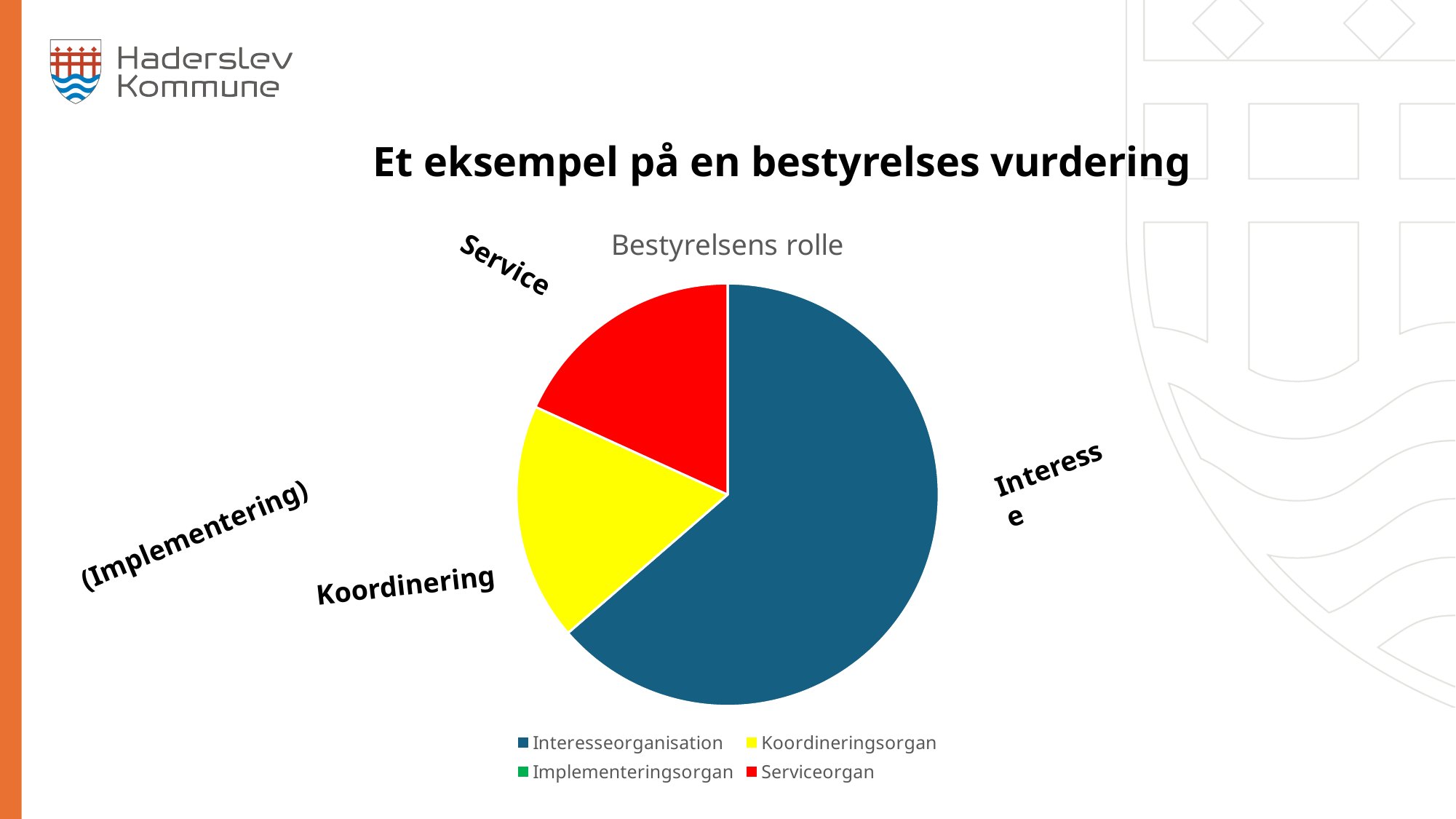
Does the Interesseorganisation slice take up more or less than half of the pie? more Which legend entry has no visible slice in the pie? Implementeringsorgan Which category has the largest slice of the pie? Interesseorganisation What colour is the Koordineringsorgan slice? yellow What kind of chart is shown on the slide? pie chart What is the title of the chart? Bestyrelsens rolle Which slice is larger, Interesseorganisation or Koordineringsorgan? Interesseorganisation How many slices are visible in the pie? 3 Which slice is larger, Interesseorganisation or Serviceorgan? Interesseorganisation How many entries does the chart's legend list? 4